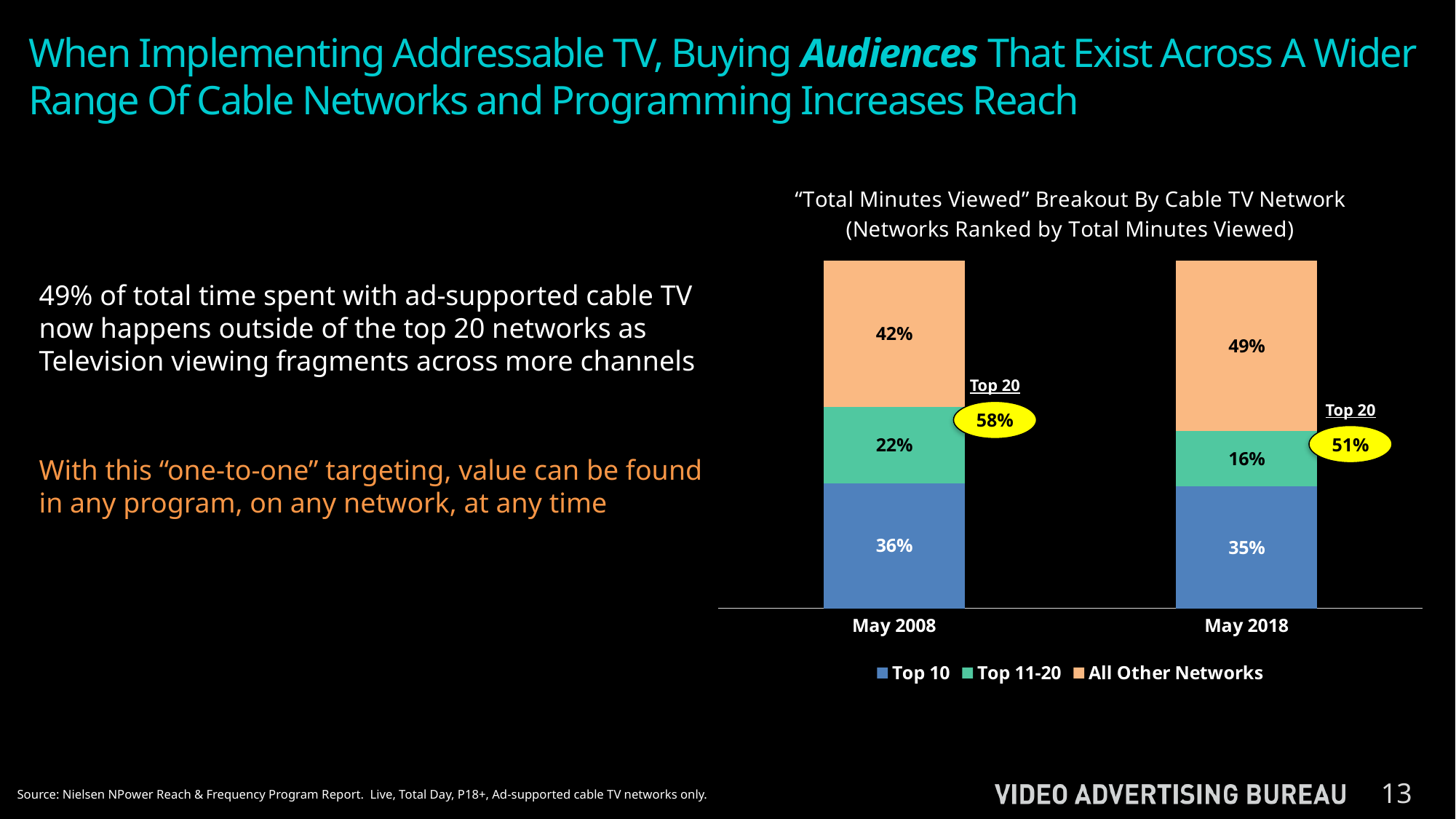
What share of total minutes viewed did All Other Networks account for in May 2018? 49% Which segment is the largest in the May 2018 bar? All Other Networks What is the value for Top 11-20 in May 2018? 16% By how many percentage points did the All Other Networks share change from May 2008 to May 2018? 7 percentage points Which segment is the smallest in the May 2018 bar? Top 11-20 Which is larger: the Top 11-20 share in May 2008 or in May 2018? May 2008 Did the Top 20 share rise or fall from May 2008 to May 2018? Fall What share of total minutes viewed did the Top 10 networks account for in May 2008? 36% What type of chart is shown on the slide? Stacked bar chart How many series does the legend list? 3 How many time periods are shown on the x axis? 2 What is the Top 20 share shown for May 2008? 58%